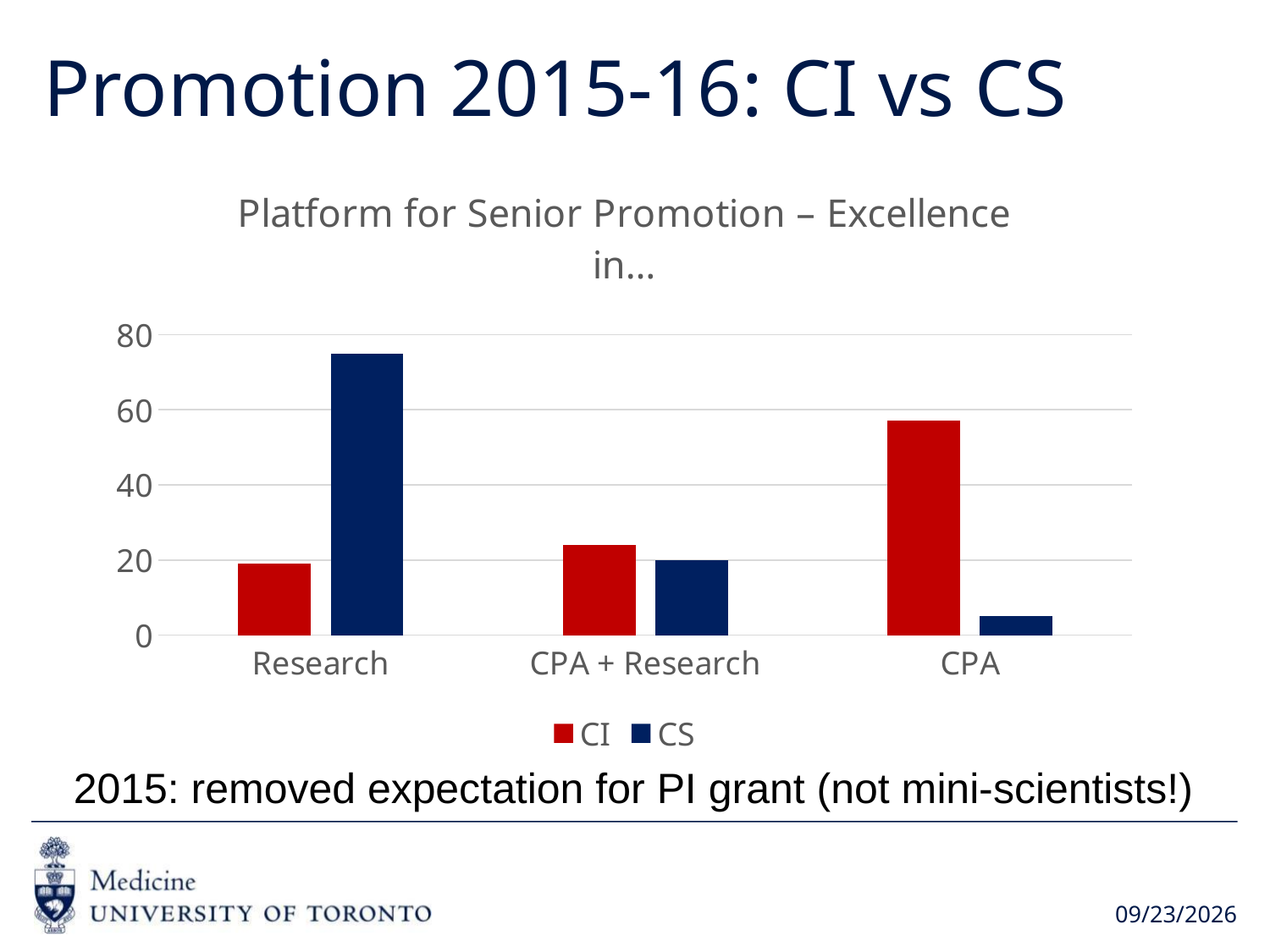
Is the CS value for CPA greater or less than 20? less How many series does the chart's legend list? 2 For the CPA category, which is larger, CI or CS? CI For the Research category, which is larger, CI or CS? CS How many categories are shown on the x axis of the chart? 3 Which category has the lowest CS value? CPA Is the CI value for CPA greater or less than 40? greater Is the CS value for Research greater or less than 60? greater Which category has the highest CS value? Research What kind of chart is shown on the slide? bar chart Which colour represents the CS series in the chart? dark blue Which category has the highest CI value? CPA